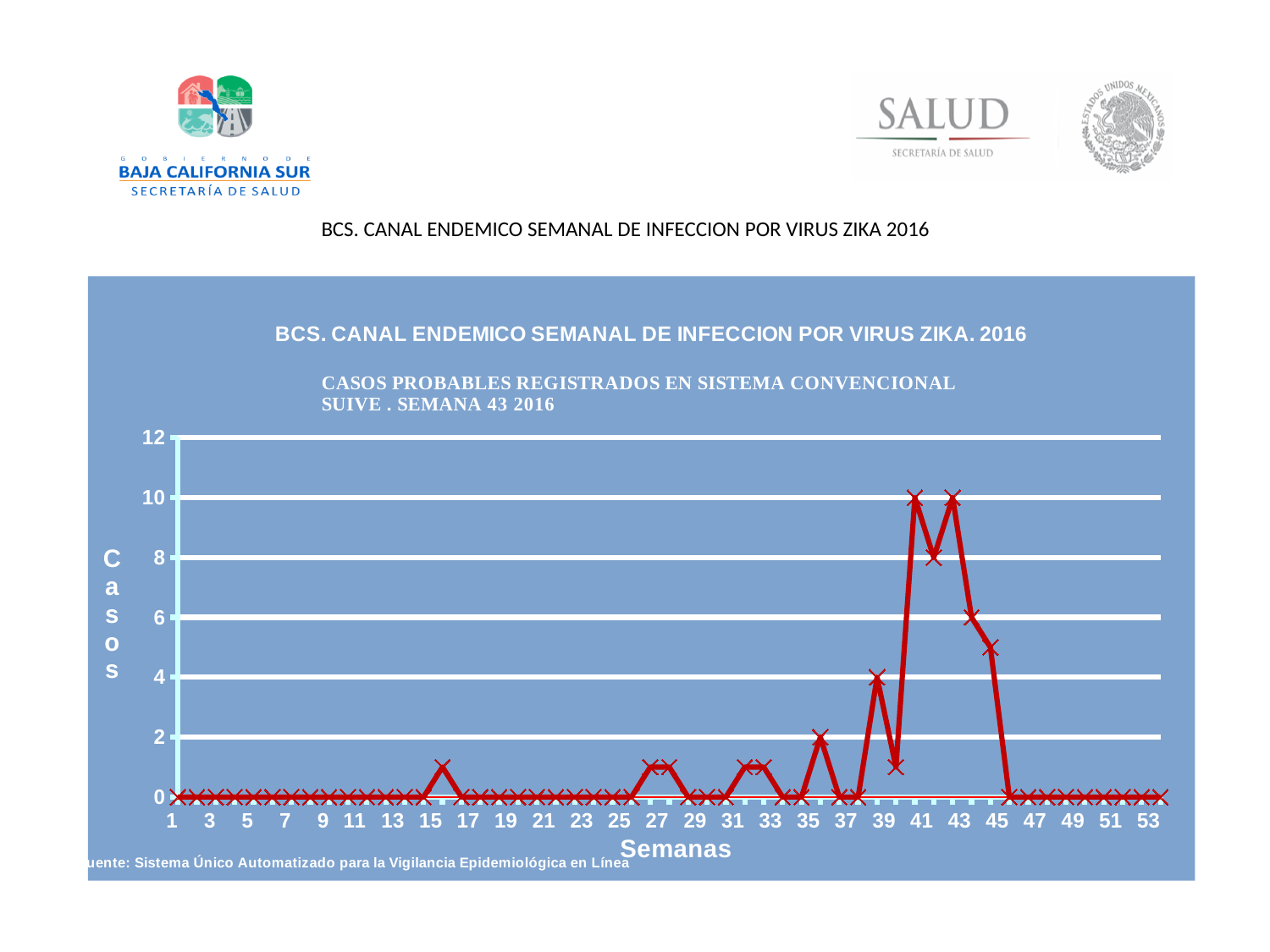
What is the highest number of cases reached on the chart? 10 Do the values rise or fall from week 43 to week 46? fall What is the difference in cases between week 41 and week 42? 2 How many cases are plotted for week 36? 0 Is the value for week 45 greater or less than 4? less How many cases are plotted for week 41? 8 How many cases are plotted for week 42? 10 What is the label of the x axis? Semanas What kind of chart is shown on the slide? line chart Which week has more cases, week 39 or week 44? week 44